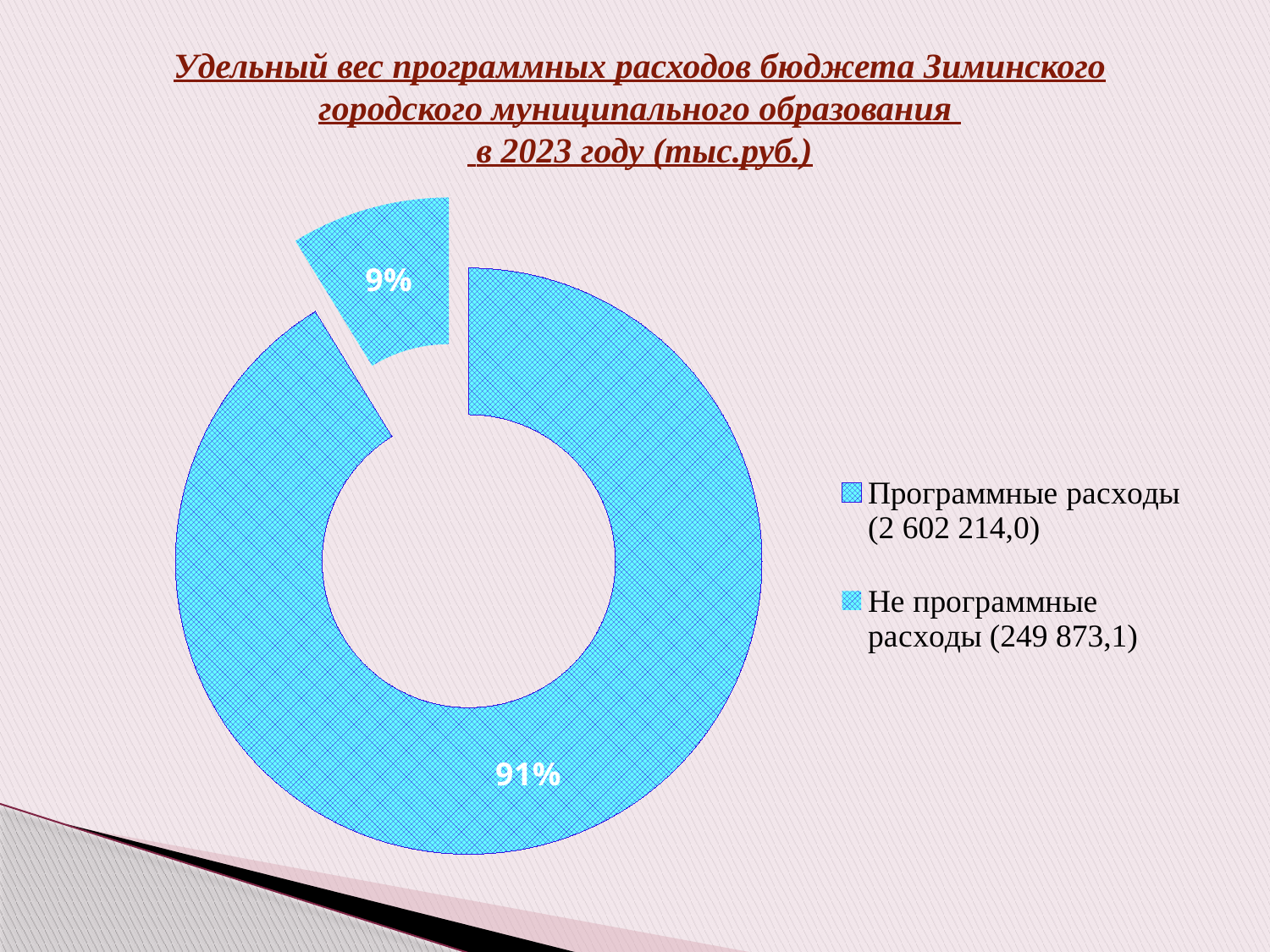
What value (in тыс.руб.) is given in the legend for "Программные расходы"? 2 602 214,0 How many categories (slices) does the chart have? 2 Which is larger: the share of "Программные расходы" or the share of "Не программные расходы"? Программные расходы Which category has the smallest share of the chart? Не программные расходы What is the difference in percentage points between the shares of "Программные расходы" and "Не программные расходы"? 82 percentage points What share of the chart does "Программные расходы" take? 91% What value (in тыс.руб.) is given in the legend for "Не программные расходы"? 249 873,1 What share of the chart does "Не программные расходы" take? 9% Which year does the chart title refer to? 2023 What kind of chart is shown on the slide? Doughnut (pie) chart How many entries does the chart legend list? 2 Which category has the largest share of the chart? Программные расходы